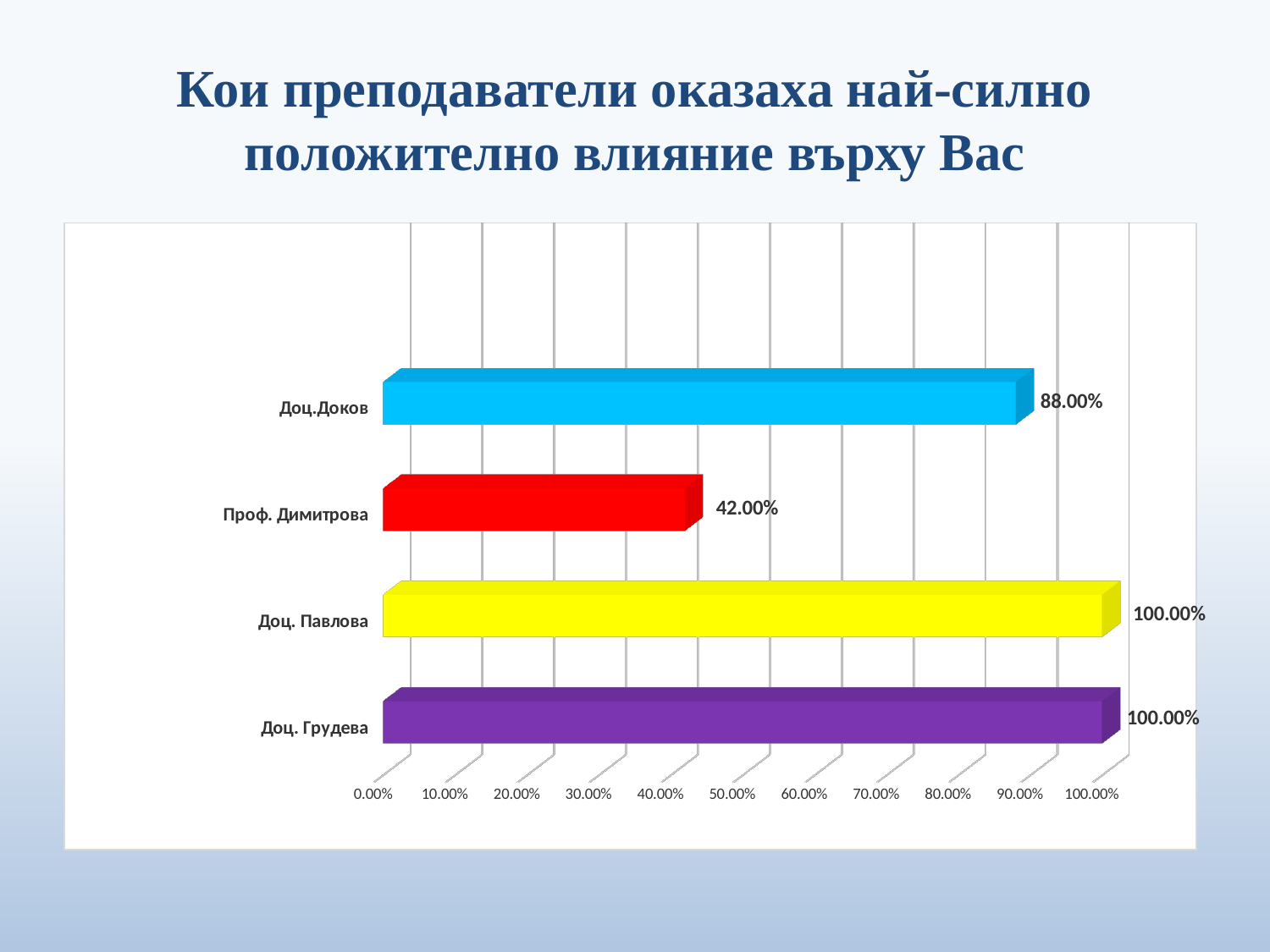
What is the value for Проф. Димитрова? 42.00% What colour is the bar for Проф. Димитрова? red What is the difference between the values for Доц. Павлова and Доц.Доков? 12.00% How many categories are shown in the chart? 4 What is the value for Доц.Доков? 88.00% What is the difference between the values for Доц.Доков and Проф. Димитрова? 46.00% What is the value for Доц. Павлова? 100.00% Which is larger, the value for Доц.Доков or the value for Проф. Димитрова? Доц.Доков Is the value for Проф. Димитрова greater or less than 50.00%? less What kind of chart is shown on the slide? bar chart What is the value for Доц. Грудева? 100.00% Which category has the lowest value? Проф. Димитрова